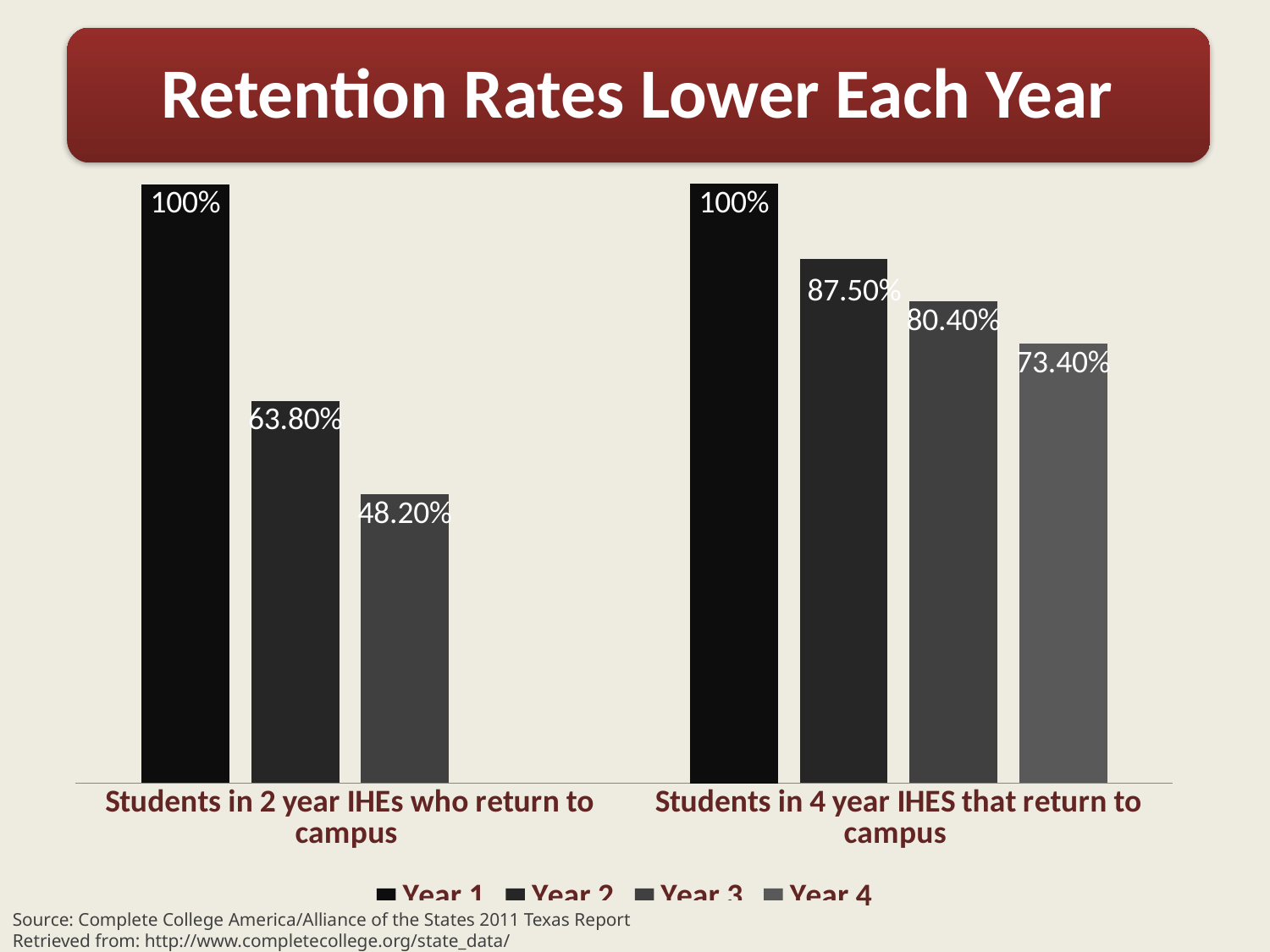
How many series does the legend list? 4 What is the Year 4 value for Students in 4 year IHES that return to campus? 73.40% What is the Year 3 value for Students in 2 year IHEs who return to campus? 48.20% What is the title of the chart? Retention Rates Lower Each Year What is the difference between the Year 2 and Year 3 values for Students in 4 year IHES that return to campus? 7.10% What is the Year 2 value for Students in 4 year IHES that return to campus? 87.50% What kind of chart is shown on the slide? Bar chart Which is larger, the Year 3 value for 2 year IHEs or the Year 3 value for 4 year IHES? 4 year IHES Do the values for Students in 4 year IHES that return to campus rise or fall from Year 1 to Year 4? Fall What is the Year 3 value for Students in 4 year IHES that return to campus? 80.40% What is the Year 2 value for Students in 2 year IHEs who return to campus? 63.80% How many categories are shown on the x axis? 2